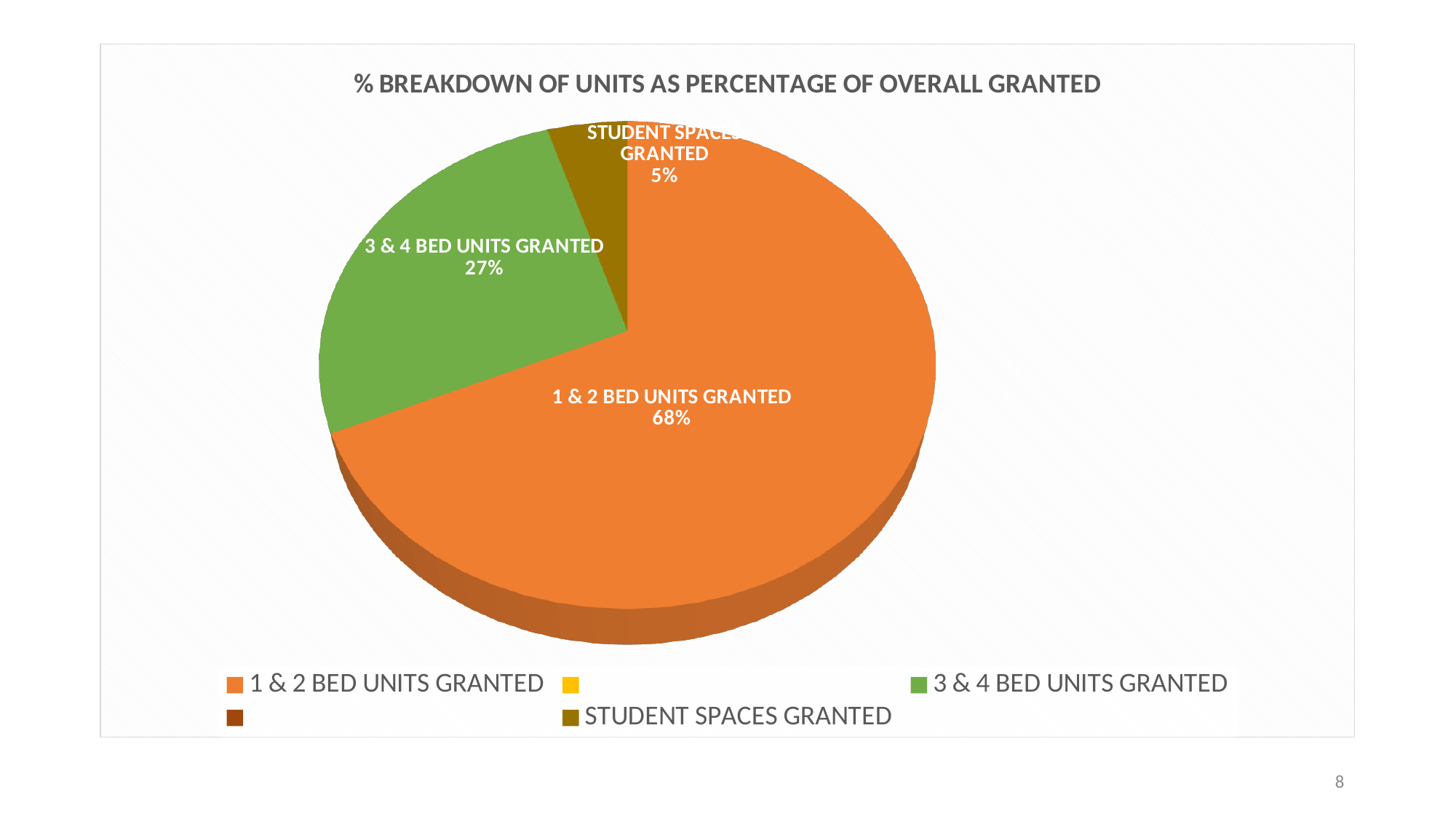
What percentage of the pie is 1 & 2 BED UNITS GRANTED? 68% What colour is the slice for 3 & 4 BED UNITS GRANTED? Green What is the difference in percentage points between 3 & 4 BED UNITS GRANTED and STUDENT SPACES GRANTED? 22 Which is larger, the share for 3 & 4 BED UNITS GRANTED or the share for STUDENT SPACES GRANTED? 3 & 4 BED UNITS GRANTED What is the title of the chart? % BREAKDOWN OF UNITS AS PERCENTAGE OF OVERALL GRANTED Which slice of the pie is the largest? 1 & 2 BED UNITS GRANTED What is the difference in percentage points between 1 & 2 BED UNITS GRANTED and 3 & 4 BED UNITS GRANTED? 41 Which slice of the pie is the smallest? STUDENT SPACES GRANTED What percentage of the pie is 3 & 4 BED UNITS GRANTED? 27% How many slices with data labels does the pie chart show? 3 What type of chart is shown on the slide? Pie chart What percentage of the pie is STUDENT SPACES GRANTED? 5%